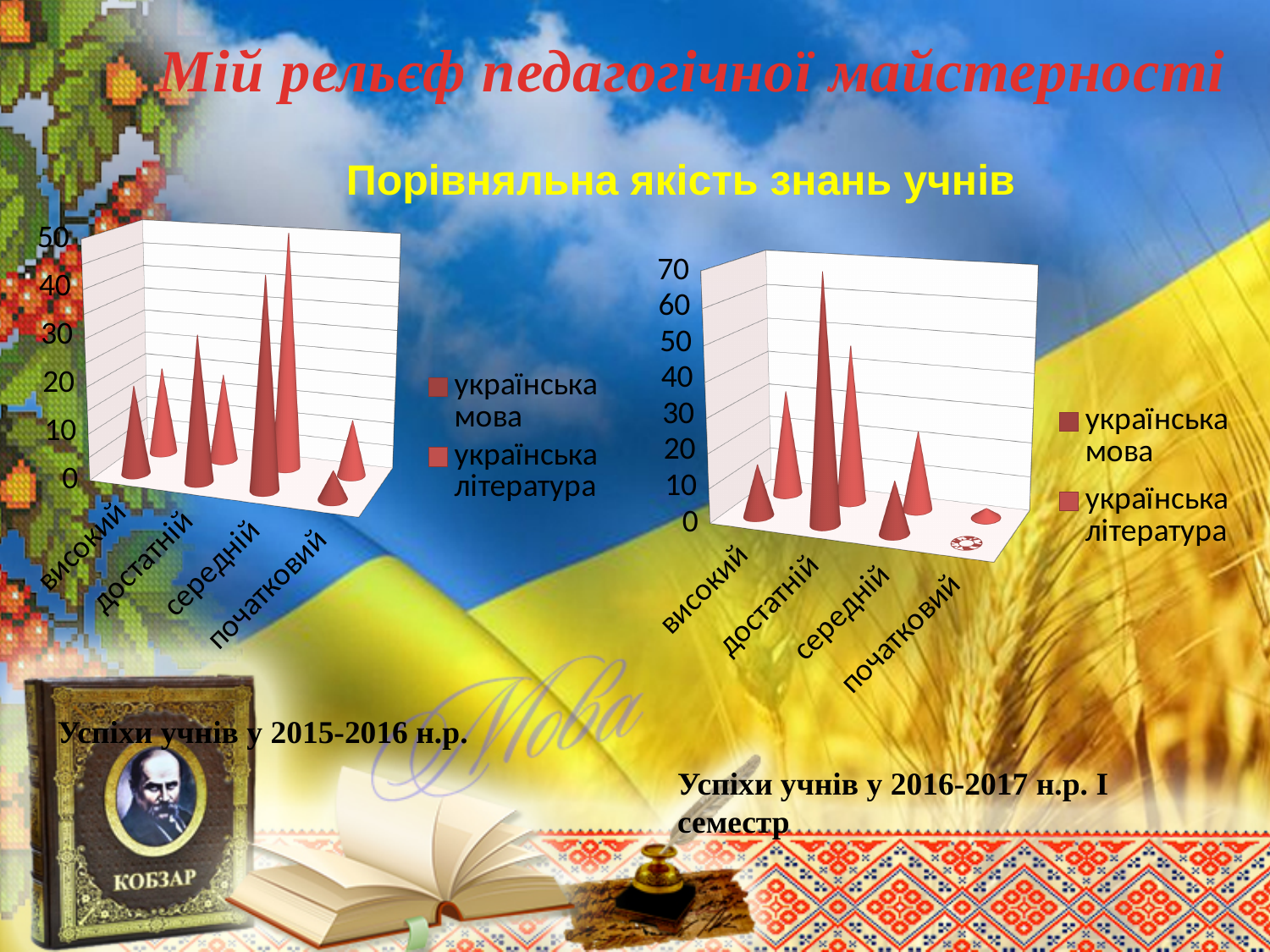
How many categories does the left chart (Успіхи учнів у 2015-2016 н.р.) show on its x axis? 4 What are the two legend entries of the left chart (Успіхи учнів у 2015-2016 н.р.)? українська мова, українська література In the left chart (Успіхи учнів у 2015-2016 н.р.), is the value for середній українська література greater or less than 40? greater In the left chart (Успіхи учнів у 2015-2016 н.р.), which category has the highest value for українська література? середній How many series does the legend of the right chart (Успіхи учнів у 2016-2017 н.р. І семестр) list? 2 In the right chart (Успіхи учнів у 2016-2017 н.р. І семестр), which is larger for достатній: українська мова or українська література? українська мова In the right chart (Успіхи учнів у 2016-2017 н.р. І семестр), which category has the highest value for українська мова? достатній In the left chart (Успіхи учнів у 2015-2016 н.р.), which category has the lowest value for українська мова? початковий In the right chart (Успіхи учнів у 2016-2017 н.р. І семестр), is the value for початковий українська література greater or less than 10? less What kind of chart is the left chart (Успіхи учнів у 2015-2016 н.р.)? bar chart In the right chart (Успіхи учнів у 2016-2017 н.р. І семестр), is the value for достатній українська мова greater or less than 60? greater In the right chart (Успіхи учнів у 2016-2017 н.р. І семестр), which category has the lowest value for українська література? початковий